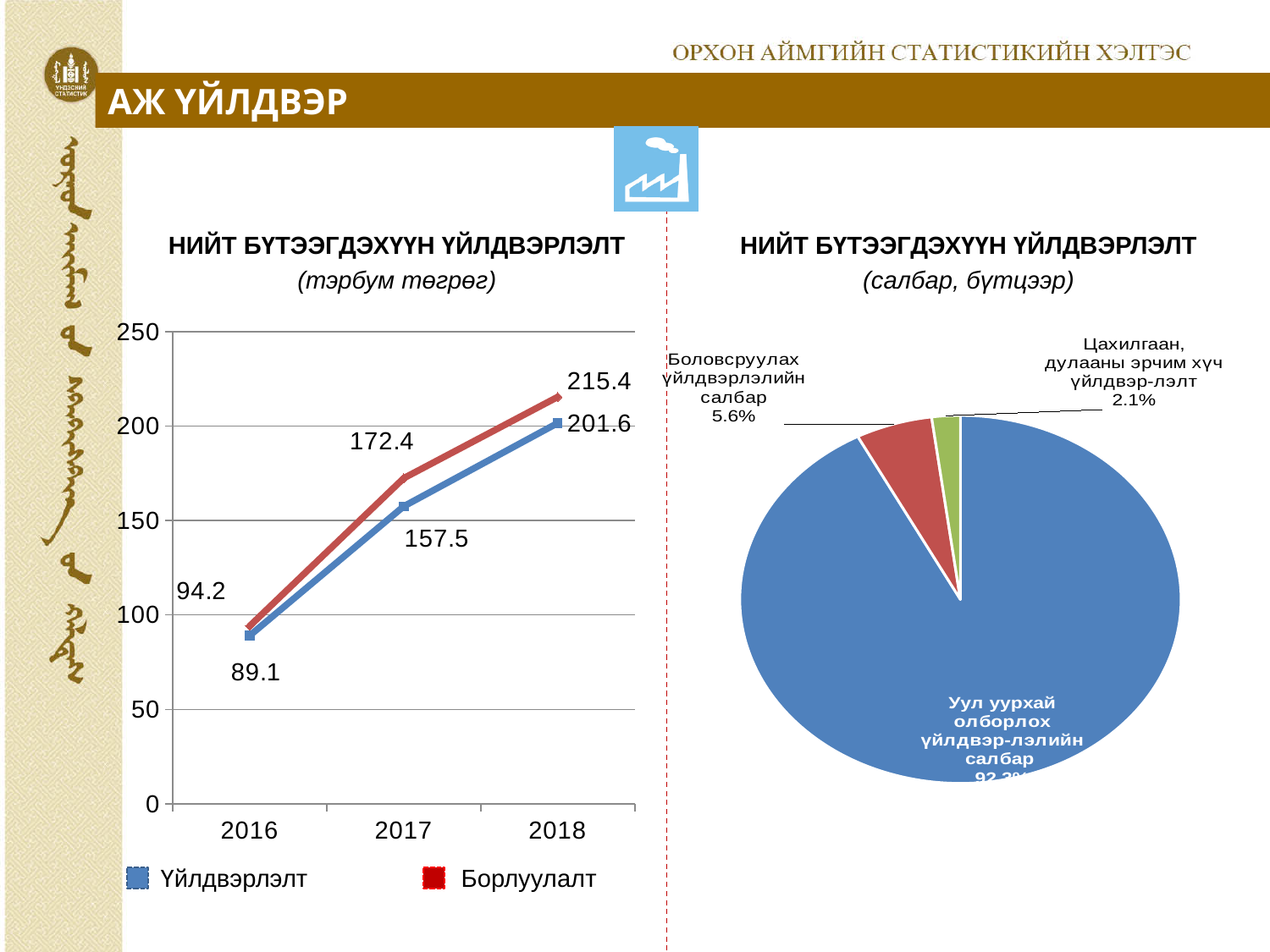
On the left chart (тэрбум төгрөг), what is the value of Үйлдвэрлэлт in 2017? 157.5 On the left chart (тэрбум төгрөг), what is the value of Үйлдвэрлэлт in 2016? 89.1 On the left chart (тэрбум төгрөг), in which year is Үйлдвэрлэлт highest? 2018 What kind of chart is the left chart (тэрбум төгрөг)? line chart On the left chart (тэрбум төгрөг), how many series does the legend list? 2 On the left chart (тэрбум төгрөг), which is larger in 2016: Үйлдвэрлэлт or Борлуулалт? Борлуулалт On the left chart (тэрбум төгрөг), do the values rise or fall from 2016 to 2018? rise On the left chart (тэрбум төгрөг), what is the value of Борлуулалт in 2018? 215.4 On the right pie chart (салбар, бүтцээр), what share does Боловсруулах үйлдвэрлэлийн салбар have? 5.6% On the right pie chart (салбар, бүтцээр), what share does Цахилгаан, дулааны эрчим хүч үйлдвэрлэлт have? 2.1% On the left chart (тэрбум төгрөг), what is the value of Борлуулалт in 2017? 172.4 On the left chart (тэрбум төгрөг), what is the difference between Борлуулалт and Үйлдвэрлэлт in 2018? 13.8